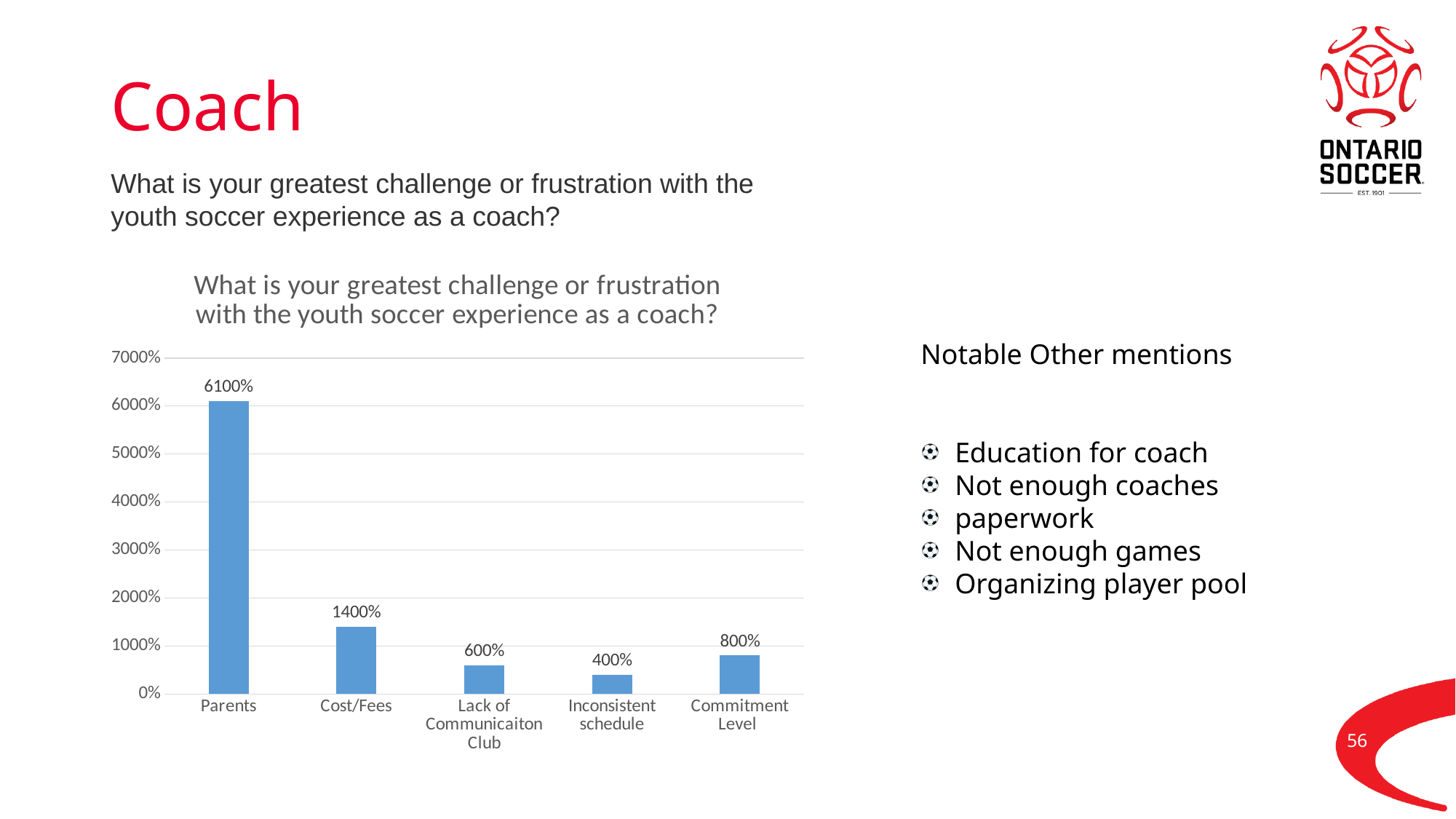
What is the value for Lack of Communicaiton Club? 600% What is the difference between the values for Parents and Cost/Fees? 4700% What kind of chart is shown on the slide? Bar chart What is the value for Commitment Level? 800% What is the value for Cost/Fees? 1400% Which category has the highest value? Parents What is the title of the chart? What is your greatest challenge or frustration with the youth soccer experience as a coach? Which category has the lowest value? Inconsistent schedule What is the value for Inconsistent schedule? 400% What is the value for Parents? 6100% How many categories are shown on the x axis? 5 Which is larger, the value for Commitment Level or the value for Lack of Communicaiton Club? Commitment Level